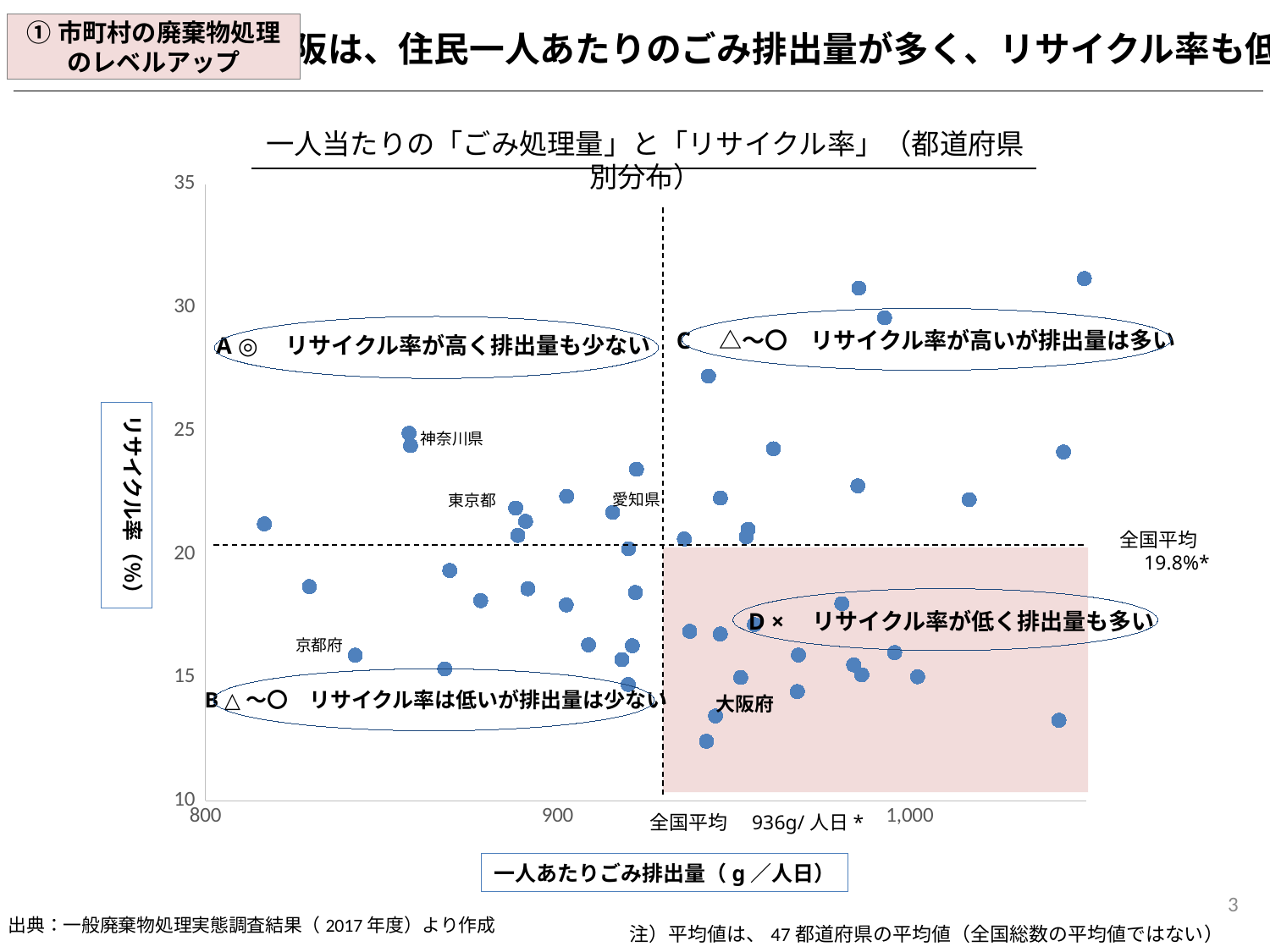
Which quadrant label is marked with ×? D リサイクル率が低く排出量も多い Which has the higher recycling rate, 東京都 or 京都府? 東京都 Is the per-capita waste output for 大阪府 greater or less than 900? greater Is the recycling rate for 大阪府 greater or less than 15? less Is the per-capita waste output for 京都府 greater or less than 900? less What is the label of the y axis? リサイクル率（%） What kind of chart is shown on the slide? scatter chart What is the national average recycling rate (全国平均) marked by the horizontal dashed line? 19.8% What is the national average per-capita waste output (全国平均) marked by the vertical dashed line? 936g/人日 Which has the higher recycling rate, 神奈川県 or 大阪府? 神奈川県